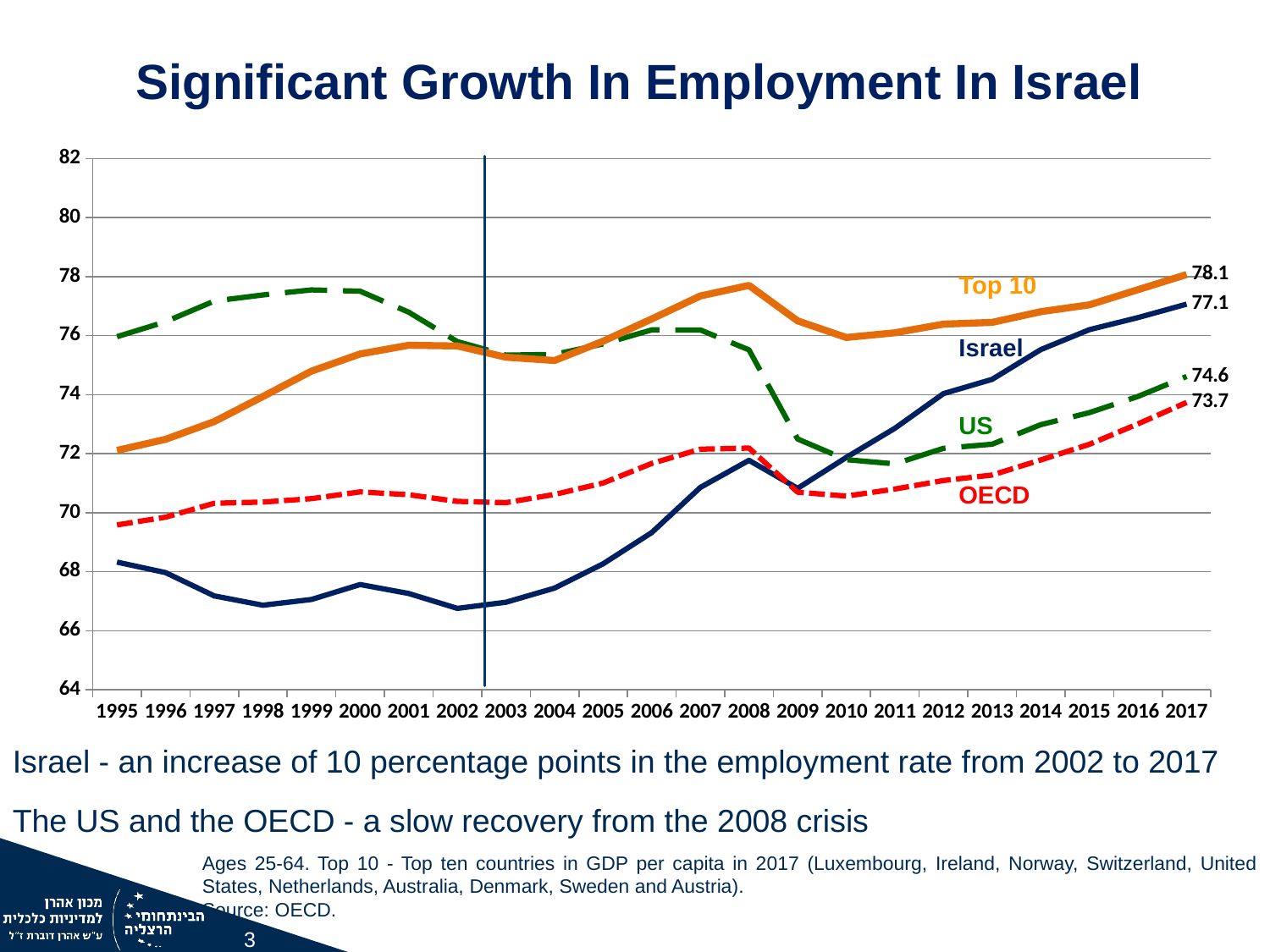
Does the Israel line rise or fall between 2002 and 2017? rise Which series has the highest value in 2017? Top 10 How many series are plotted on the chart? 4 What kind of chart is shown on the slide? line chart What is the employment rate for the OECD in 2017? 73.7 What is the difference between the Top 10 and Israel values in 2017? 1.0 In 1995, which is higher, the US or the Top 10? US What is the employment rate for the US in 2017? 74.6 Is the value for Israel in 1995 greater or less than 70? less Which series has the lowest value in 2017? OECD What is the employment rate for the Top 10 series in 2017? 78.1 What is the employment rate for Israel in 2017? 77.1